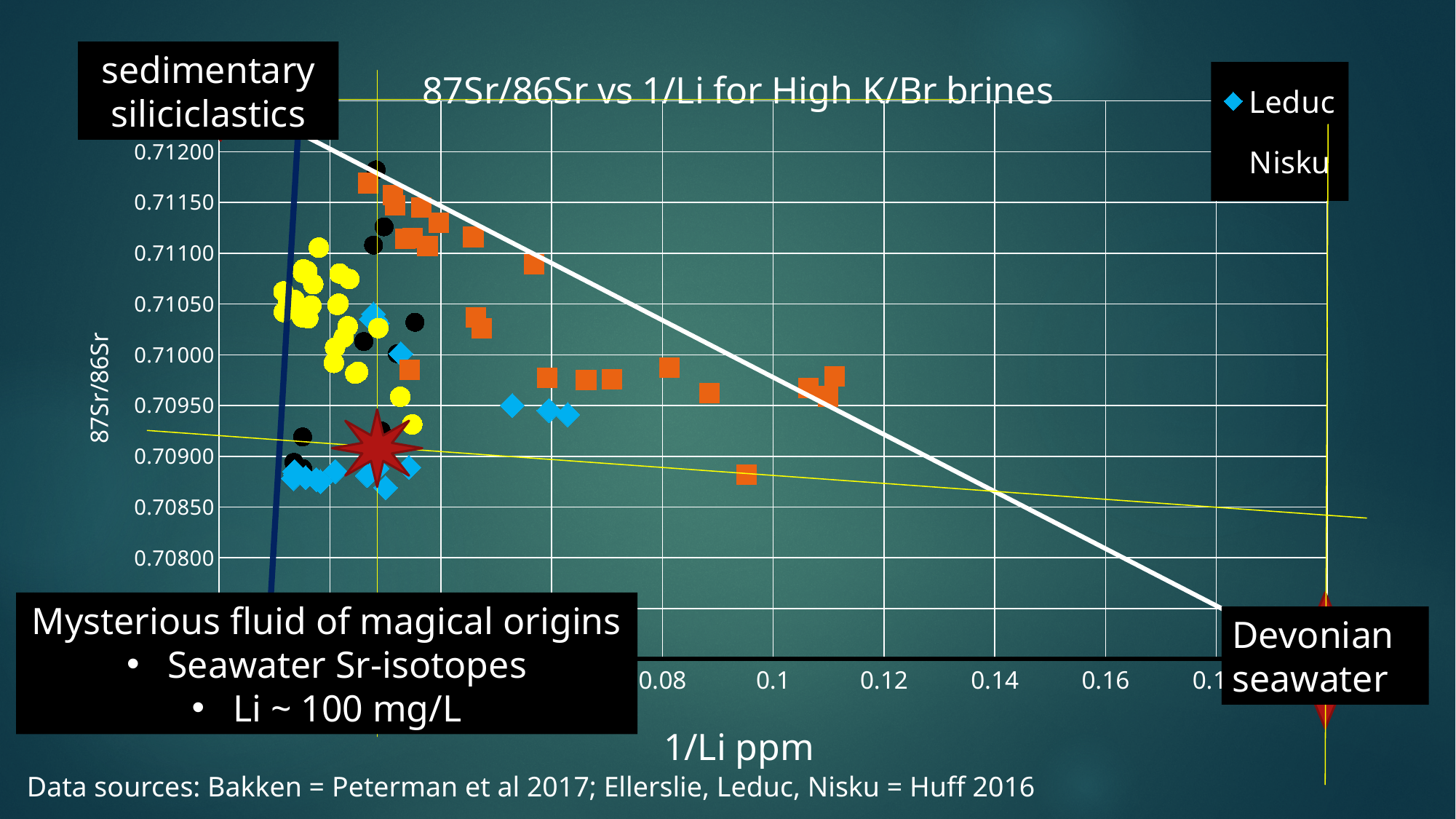
What kind of chart is shown on the slide? scatter chart Does the white line drawn across the chart rise or fall as 1/Li increases along the x axis? fall Is the highest 87Sr/86Sr value among the orange square points greater or less than 0.71100? greater How many series does the chart's legend list? 2 What is the title of the chart? 87Sr/86Sr vs 1/Li for High K/Br brines Is the lowest 87Sr/86Sr value among the Leduc (blue diamond) points greater or less than 0.70800? greater Which two series names appear in the chart's legend? Leduc and Nisku Is the largest 1/Li value among the Leduc (blue diamond) points greater or less than 0.08? less